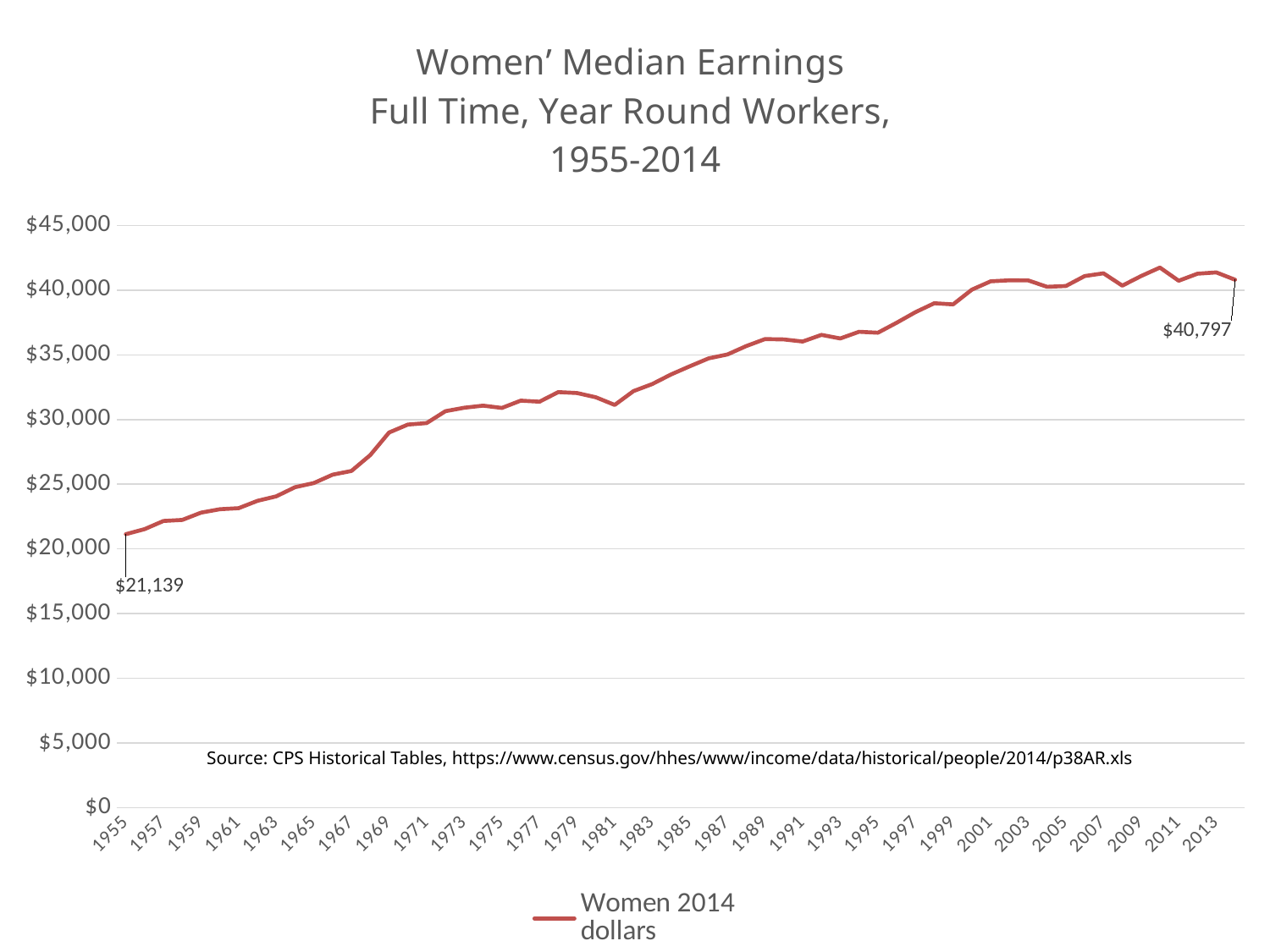
What kind of chart is shown on the slide? line chart Which year has the lowest women's median earnings on the chart? 1955 Is the value for 1981 greater or less than $35,000? less Is the value for 1975 greater or less than $35,000? less Which is larger, the value for 1955 or the value for 2014? 2014 Do women's median earnings generally rise or fall from 1955 to 2014? rise How many series does the legend list? 1 What is the women's median earnings value labeled for 1955? $21,139 What is the name of the series shown in the legend? Women 2014 dollars What is the difference between the labeled 2014 value and the labeled 1955 value? $19,658 What is the women's median earnings value labeled for 2014? $40,797 Is the value for 1969 greater or less than $25,000? greater